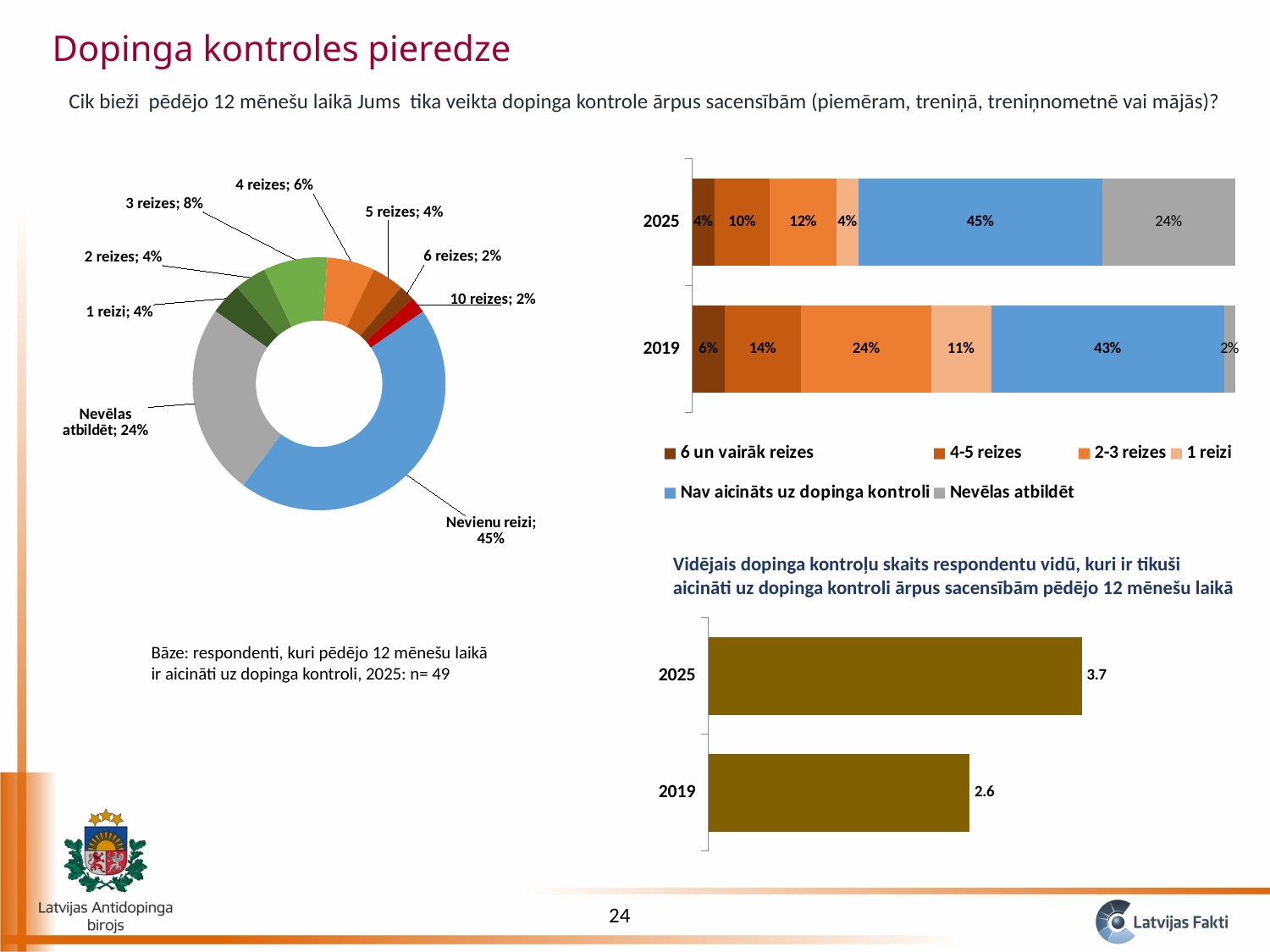
In the donut chart on the left, what share of respondents answered "Nevienu reizi"? 45% In the donut chart on the left, how many slices (categories) are shown? 9 In the stacked bar chart at the top right, how many series does the legend list? 6 In the donut chart on the left, what is the share for "3 reizes"? 8% In the chart titled "Vidējais dopinga kontroļu skaits..." at the bottom right, what is the difference between the 2025 and 2019 values? 1.1 In the donut chart on the left, which category has the largest share? Nevienu reizi In the stacked bar chart at the top right, what is the difference between the "2-3 reizes" values for 2019 and 2025? 12% In the chart titled "Vidējais dopinga kontroļu skaits..." at the bottom right, what is the value for 2025? 3.7 In the donut chart on the left, what share of respondents answered "Nevēlas atbildēt"? 24% In the stacked bar chart at the top right, what is the value for "Nav aicināts uz dopinga kontroli" in 2019? 43% In the stacked bar chart at the top right, what is the value for "2-3 reizes" in 2025? 12% In the stacked bar chart at the top right, which year has the larger value for "Nevēlas atbildēt"? 2025